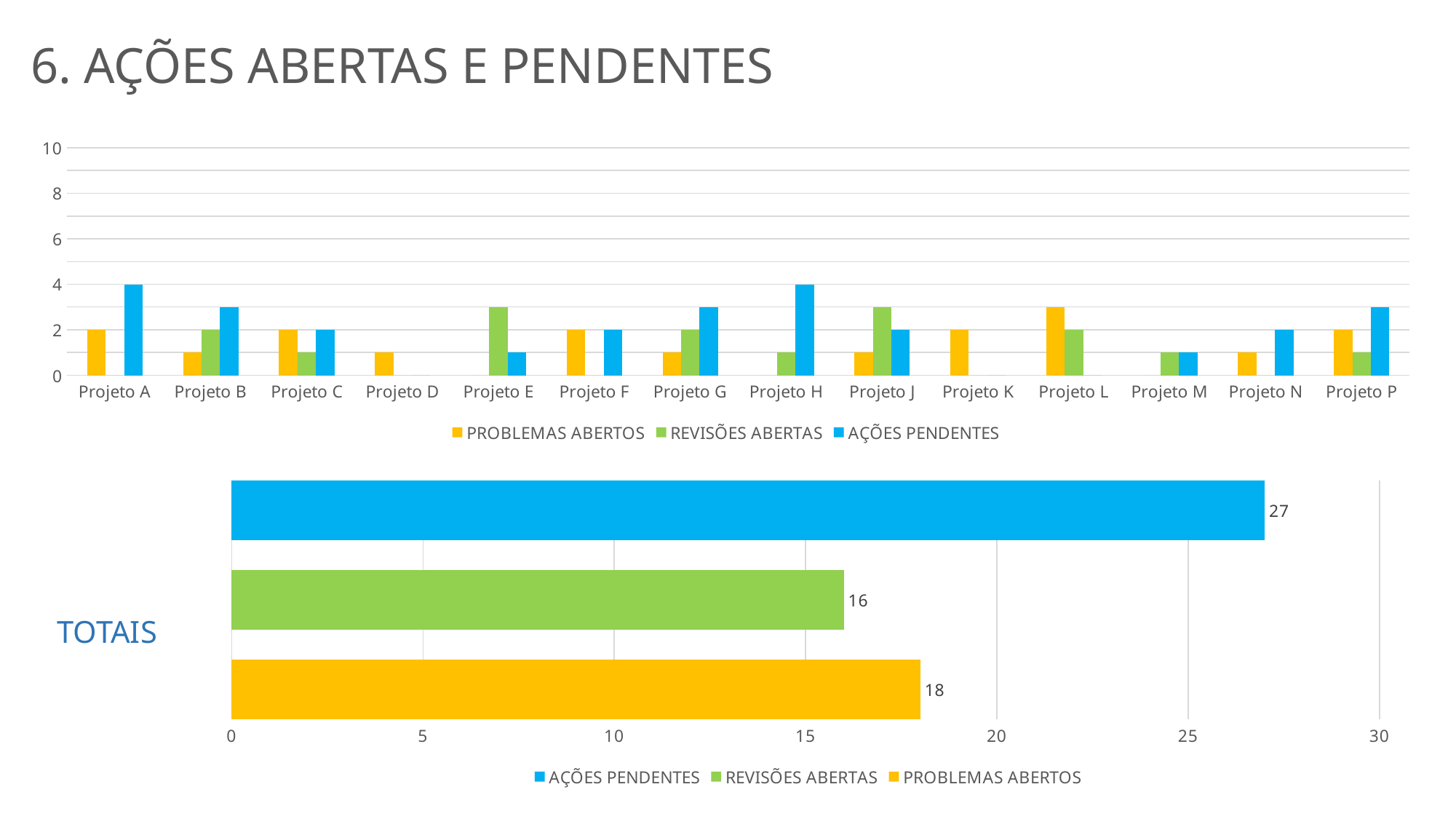
In the bottom chart (TOTAIS), which is larger, PROBLEMAS ABERTOS or REVISÕES ABERTAS? PROBLEMAS ABERTOS In the bottom chart (TOTAIS), which category has the highest value? AÇÕES PENDENTES In the bottom chart (TOTAIS), what is the value for PROBLEMAS ABERTOS? 18 In the bottom chart (TOTAIS), what is the difference between AÇÕES PENDENTES and REVISÕES ABERTAS? 11 In the bottom chart (TOTAIS), what is the value for REVISÕES ABERTAS? 16 In the top chart, how many series does the legend list? 3 In the bottom chart (TOTAIS), which category has the lowest value? REVISÕES ABERTAS In the bottom chart (TOTAIS), what is the value for AÇÕES PENDENTES? 27 In the top chart, what is the PROBLEMAS ABERTOS value for Projeto K? 2 In the top chart, what is the AÇÕES PENDENTES value for Projeto A? 4 In the top chart, how many projects are shown on the x axis? 14 In the top chart, is the PROBLEMAS ABERTOS value for Projeto L greater or less than 2? greater